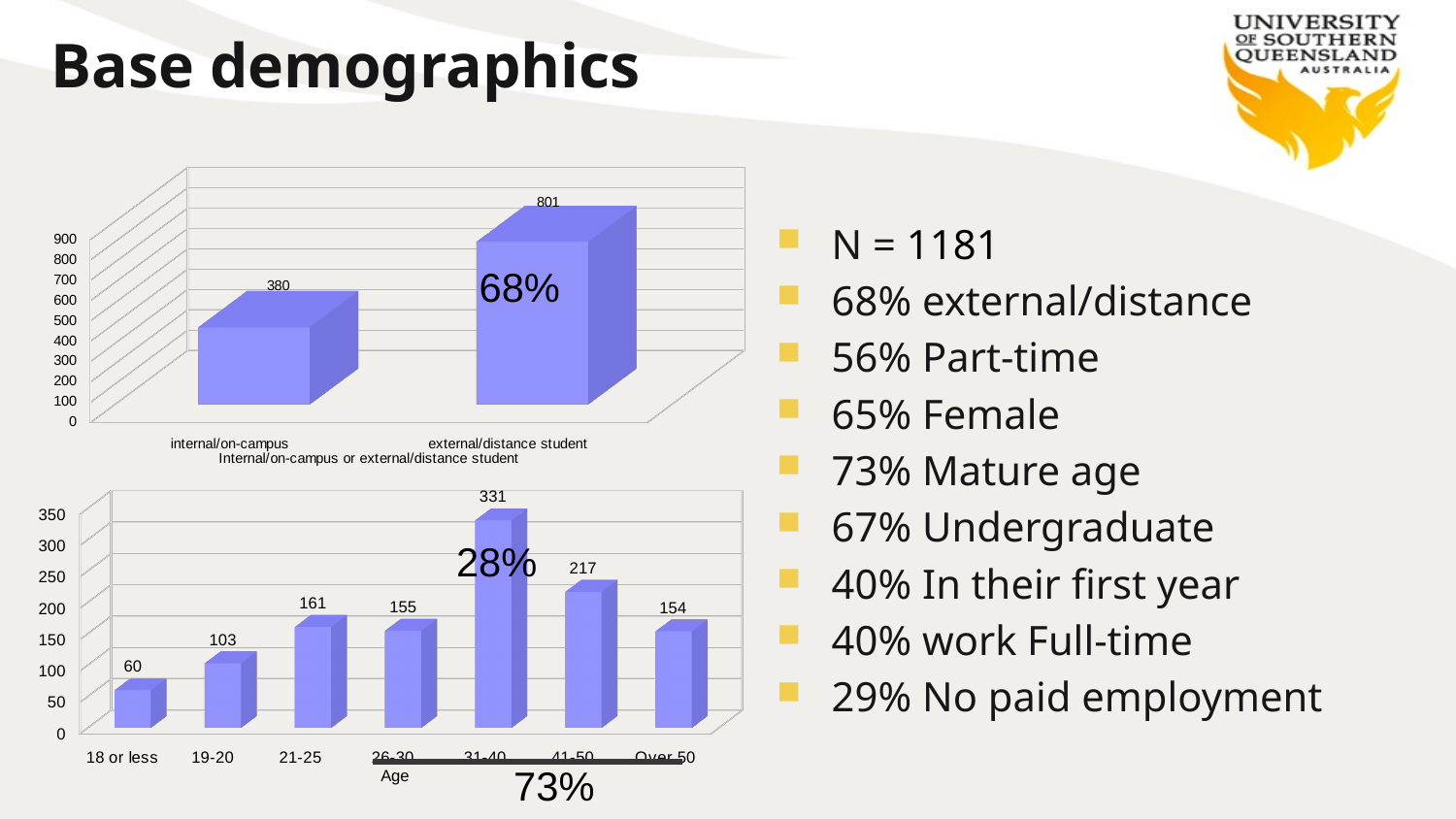
In the bottom chart (Age), how many age categories are shown? 7 In the bottom chart (Age), what is the value for the 31-40 age group? 331 In the bottom chart (Age), what is the difference between the 41-50 and Over 50 values? 63 In the bottom chart (Age), which age group has the highest value? 31-40 In the top chart (Internal/on-campus or external/distance student), what is the value for external/distance student? 801 In the top chart (Internal/on-campus or external/distance student), what is the value for internal/on-campus? 380 In the bottom chart (Age), which age group has the lowest value? 18 or less In the bottom chart (Age), is the value for 21-25 larger or smaller than the value for 26-30? larger What kind of chart is the top chart (Internal/on-campus or external/distance student)? bar chart In the top chart (Internal/on-campus or external/distance student), what is the difference between the external/distance student and internal/on-campus values? 421 In the top chart (Internal/on-campus or external/distance student), which category has the higher value? external/distance student In the bottom chart (Age), what is the value for the 19-20 age group? 103